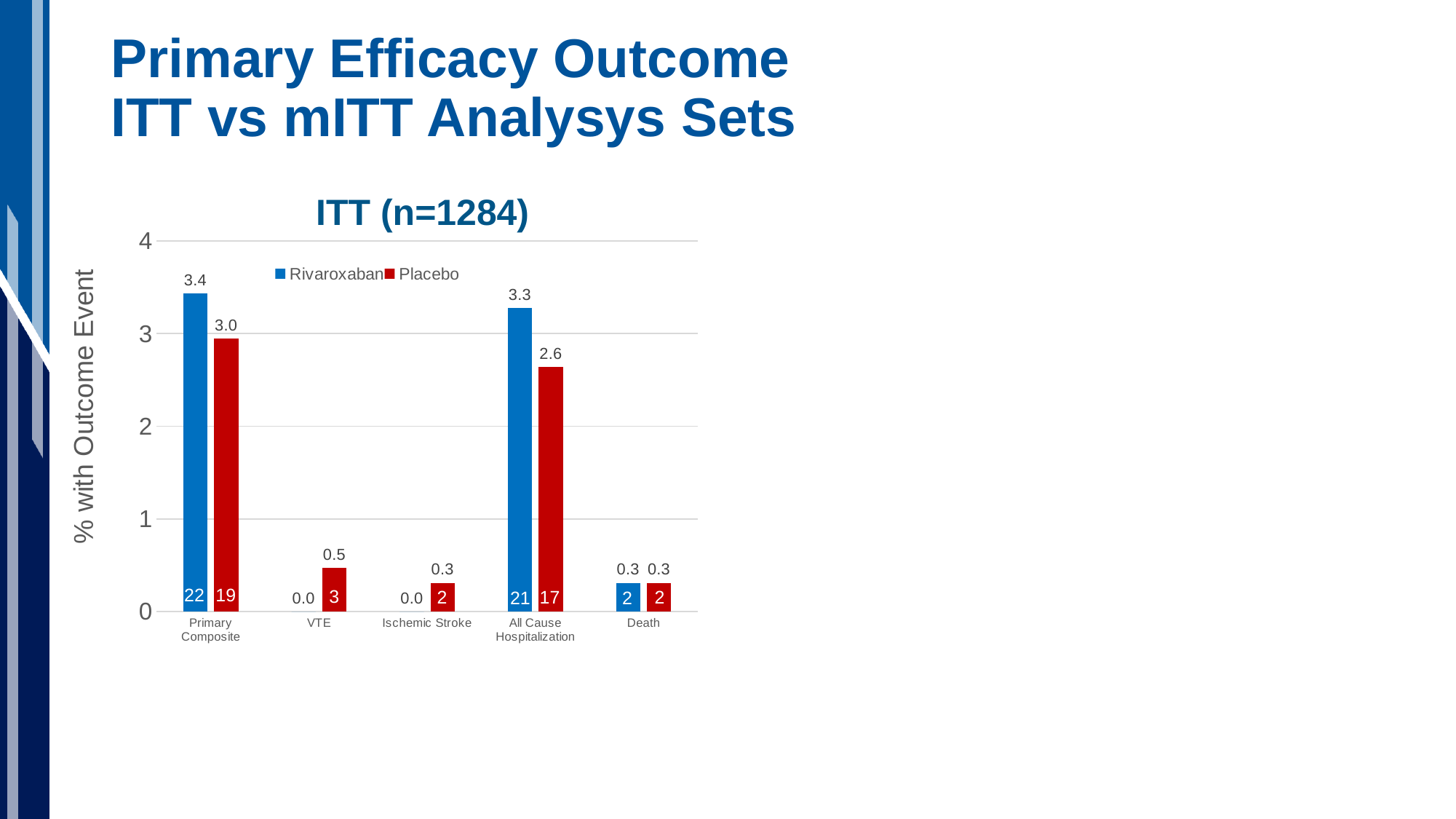
What is the Rivaroxaban value for Primary Composite? 3.4 What is the Placebo value for VTE? 0.5 What is the Rivaroxaban value for Ischemic Stroke? 0.0 Which category has the lowest Placebo value? Ischemic Stroke and Death (both 0.3) How many series does the legend list? 2 What is the difference between the Rivaroxaban and Placebo values for Primary Composite? 0.4 Which is larger for All Cause Hospitalization, Rivaroxaban or Placebo? Rivaroxaban How many categories are shown on the x axis? 5 What is the Placebo value for All Cause Hospitalization? 2.6 Which category has the highest Rivaroxaban value? Primary Composite What is the title of the chart? ITT (n=1284) What kind of chart is shown? Bar chart